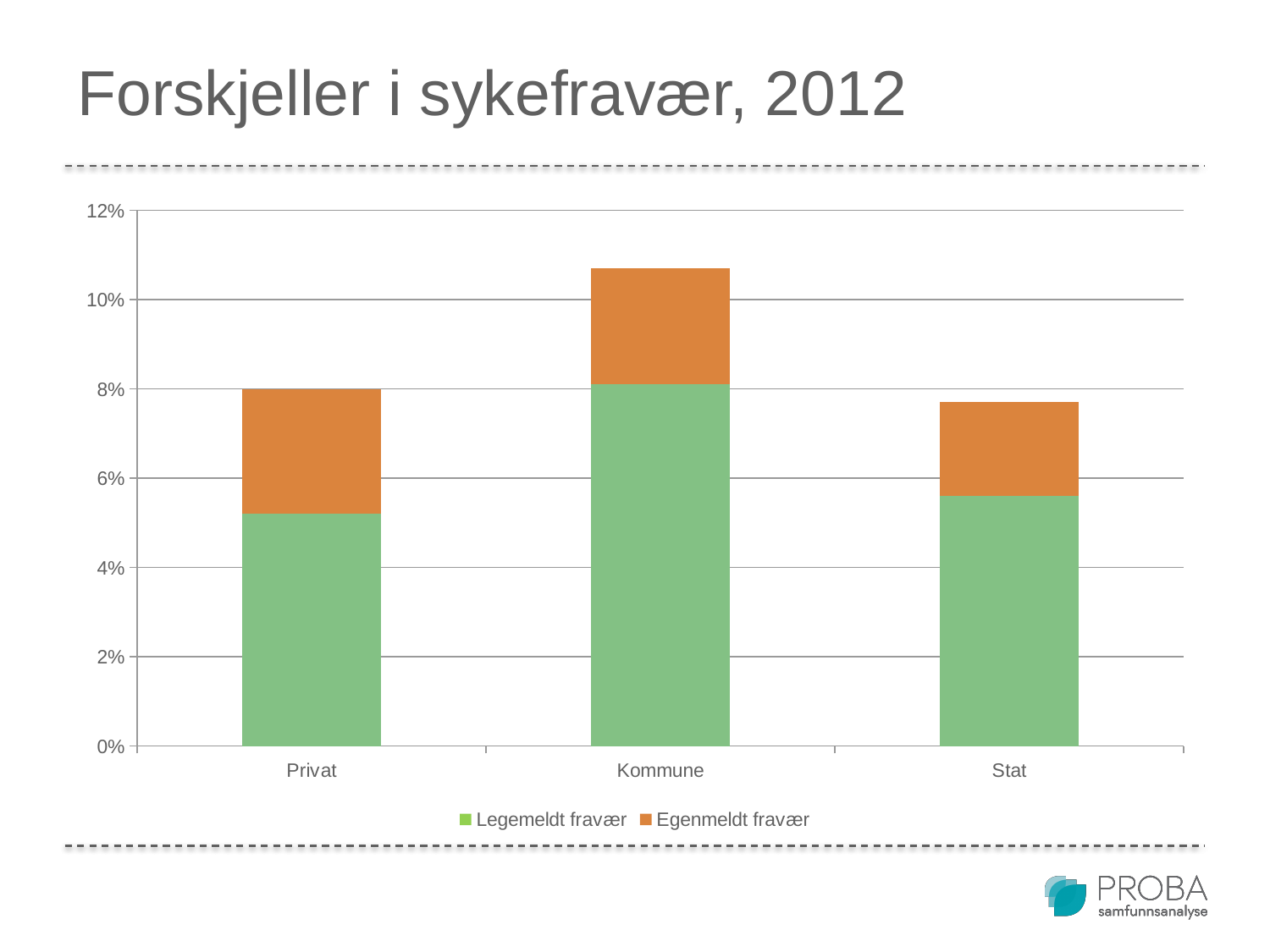
Is the total value for Stat greater or less than 8%? less What kind of chart is shown on the slide? stacked bar chart Which is larger, the Legemeldt fravær value for Kommune or for Stat? Kommune Is the Legemeldt fravær value for Privat greater or less than 6%? less What is the title of the slide? Forskjeller i sykefravær, 2012 Is the total value for Kommune greater or less than 10%? greater Which category has the highest total bar? Kommune How many series does the legend list? 2 Which category has the lowest total bar? Stat How many categories are shown on the x axis? 3 Which series is shown in orange? Egenmeldt fravær